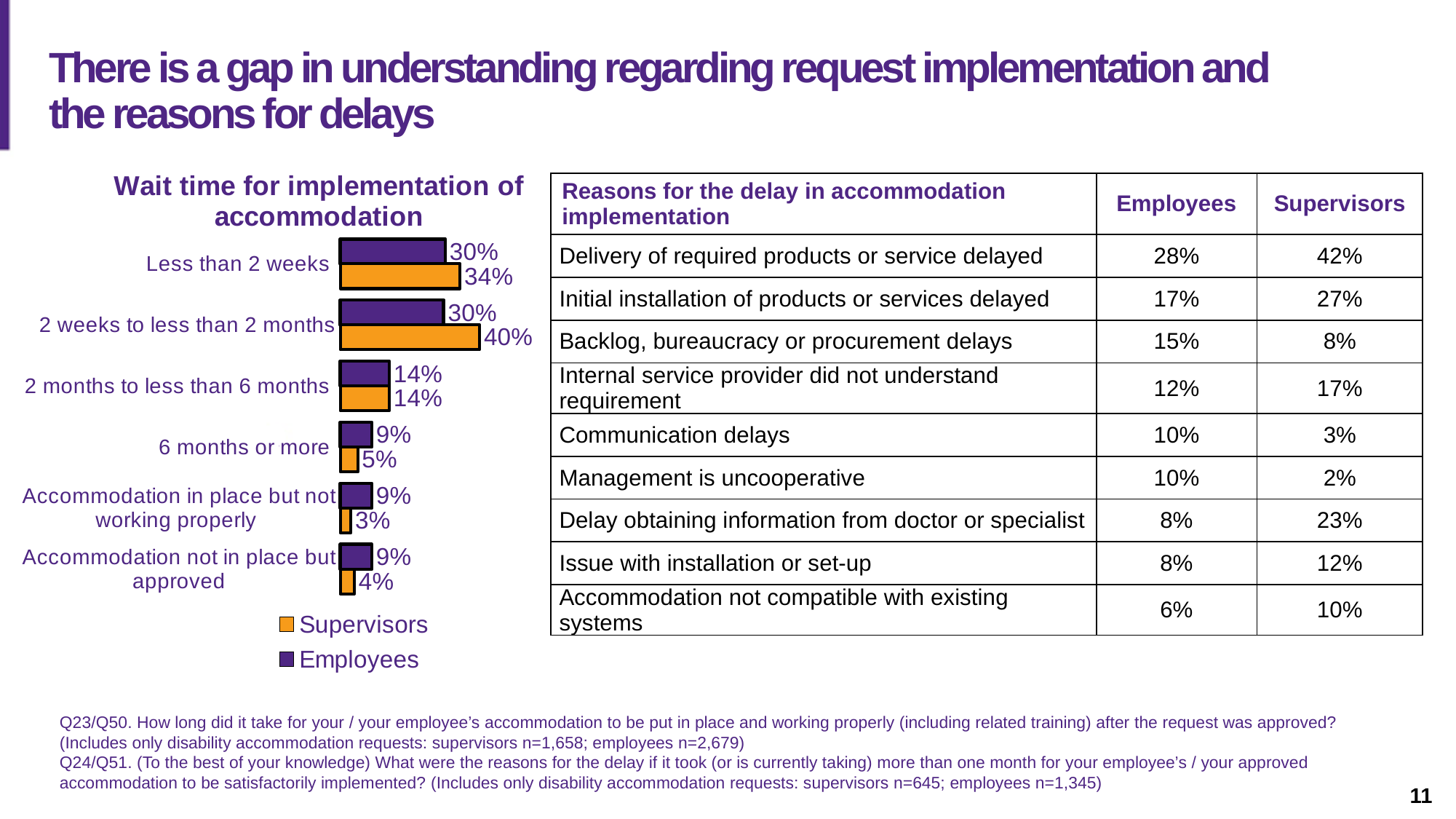
In the 'Wait time for implementation of accommodation' chart, what is the Supervisors value for '2 weeks to less than 2 months'? 40% How many series does the legend of the 'Wait time for implementation of accommodation' chart list? 2 In the 'Wait time for implementation of accommodation' chart, which category has the highest Supervisors value? 2 weeks to less than 2 months In the 'Wait time for implementation of accommodation' chart, what is the Supervisors value for 'Accommodation in place but not working properly'? 3% In the 'Wait time for implementation of accommodation' chart, what is the difference between the Supervisors and Employees values for '2 weeks to less than 2 months'? 10% In the 'Wait time for implementation of accommodation' chart, which category has the lowest Supervisors value? Accommodation in place but not working properly In the 'Wait time for implementation of accommodation' chart, what is the Employees value for 'Less than 2 weeks'? 30% In the 'Wait time for implementation of accommodation' chart, which colour represents the Supervisors series? Orange How many categories are shown in the 'Wait time for implementation of accommodation' chart? 6 In the 'Wait time for implementation of accommodation' chart, which is larger for '6 months or more': the Employees value or the Supervisors value? Employees What type of chart is used for 'Wait time for implementation of accommodation'? Bar chart In the 'Wait time for implementation of accommodation' chart, what is the difference between the Supervisors and Employees values for 'Less than 2 weeks'? 4%